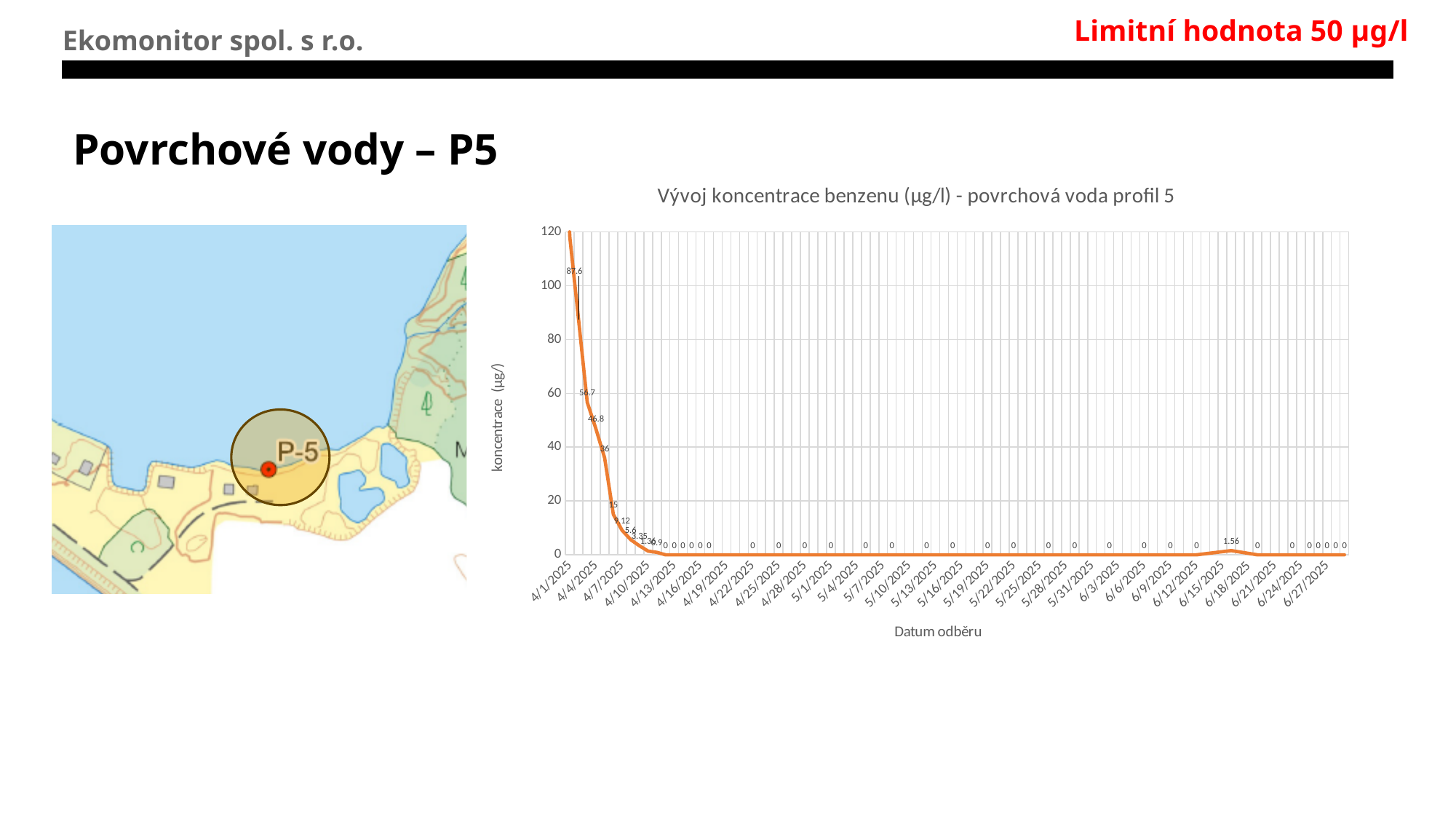
Is the value for 4/1/2025 greater or less than 100? greater What is the highest tick value shown on the y axis of the chart? 120 Do the benzene concentration values generally rise or fall along the x axis from April to June 2025? fall What is the title of the chart? Vývoj koncentrace benzenu (µg/l) - povrchová voda profil 5 What kind of chart is shown on the slide? line chart Is the value for 5/1/2025 greater or less than 20? less What is the label of the x axis of the chart? Datum odběru What is the labeled value of the small bump in the line in mid-June 2025? 1.56 Is the value for 4/10/2025 greater or less than 20? less How many data series are plotted in the chart? 1 Which is larger, the value for 4/4/2025 or the value for 5/13/2025? 4/4/2025